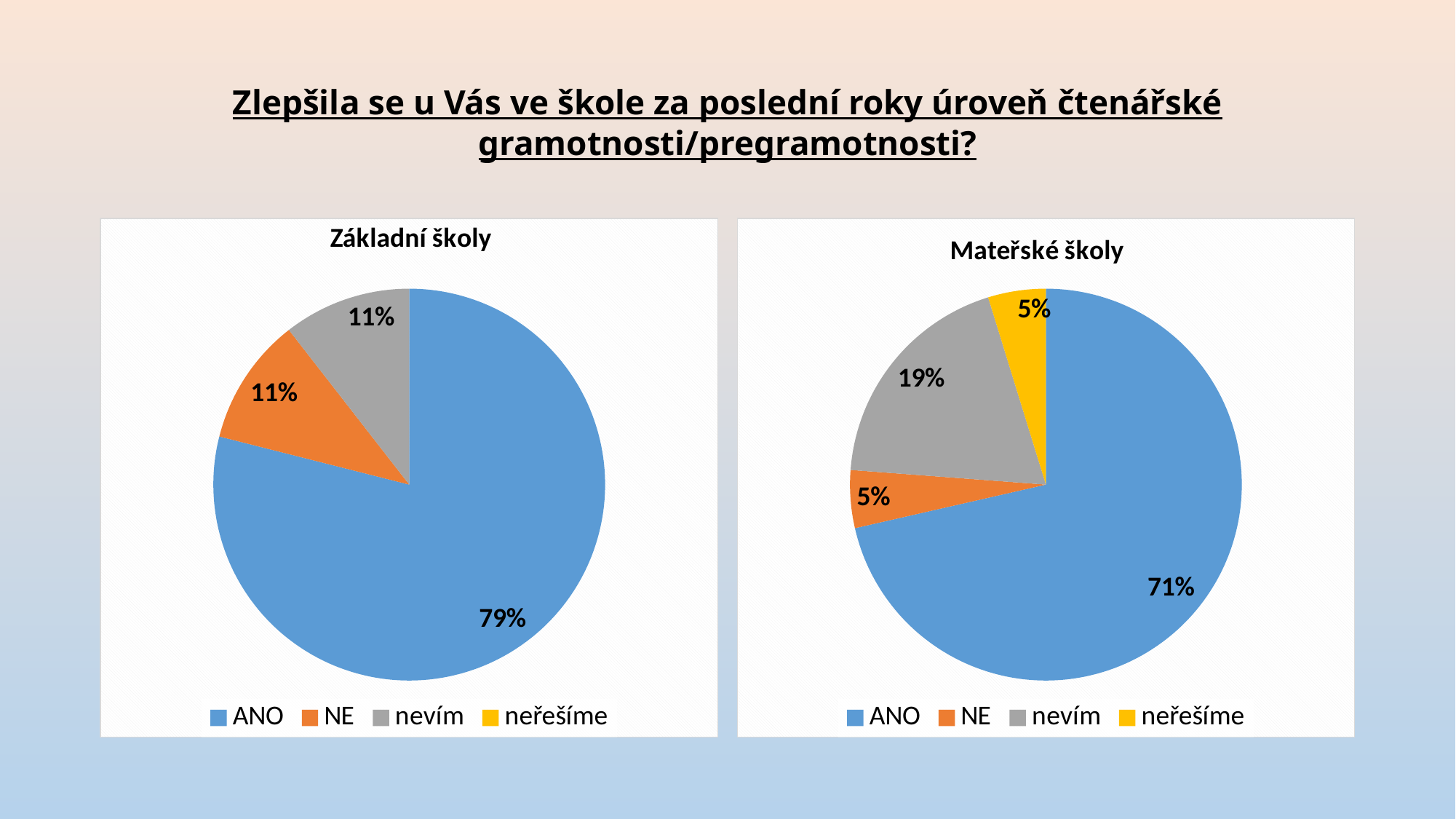
In the "Mateřské školy" chart, what share of responses is nevím? 19% In the "Mateřské školy" chart, what is the difference between the nevím share and the NE share? 14 percentage points What is the difference between the ANO share in the "Základní školy" chart and the ANO share in the "Mateřské školy" chart? 8 percentage points In the "Základní školy" chart, which category has the largest slice? ANO In the "Základní školy" chart, what share of responses is NE? 11% In the "Základní školy" chart, what share of responses is ANO? 79% Which chart has the larger ANO share, "Základní školy" or "Mateřské školy"? Základní školy In the "Mateřské školy" chart, which category has the largest slice? ANO In the "Mateřské školy" chart, what share of responses is neřešíme? 5% What type of chart is the "Základní školy" chart? Pie chart How many entries does the legend of the "Mateřské školy" chart list? 4 In the "Mateřské školy" chart, which category has the largest slice after ANO? nevím